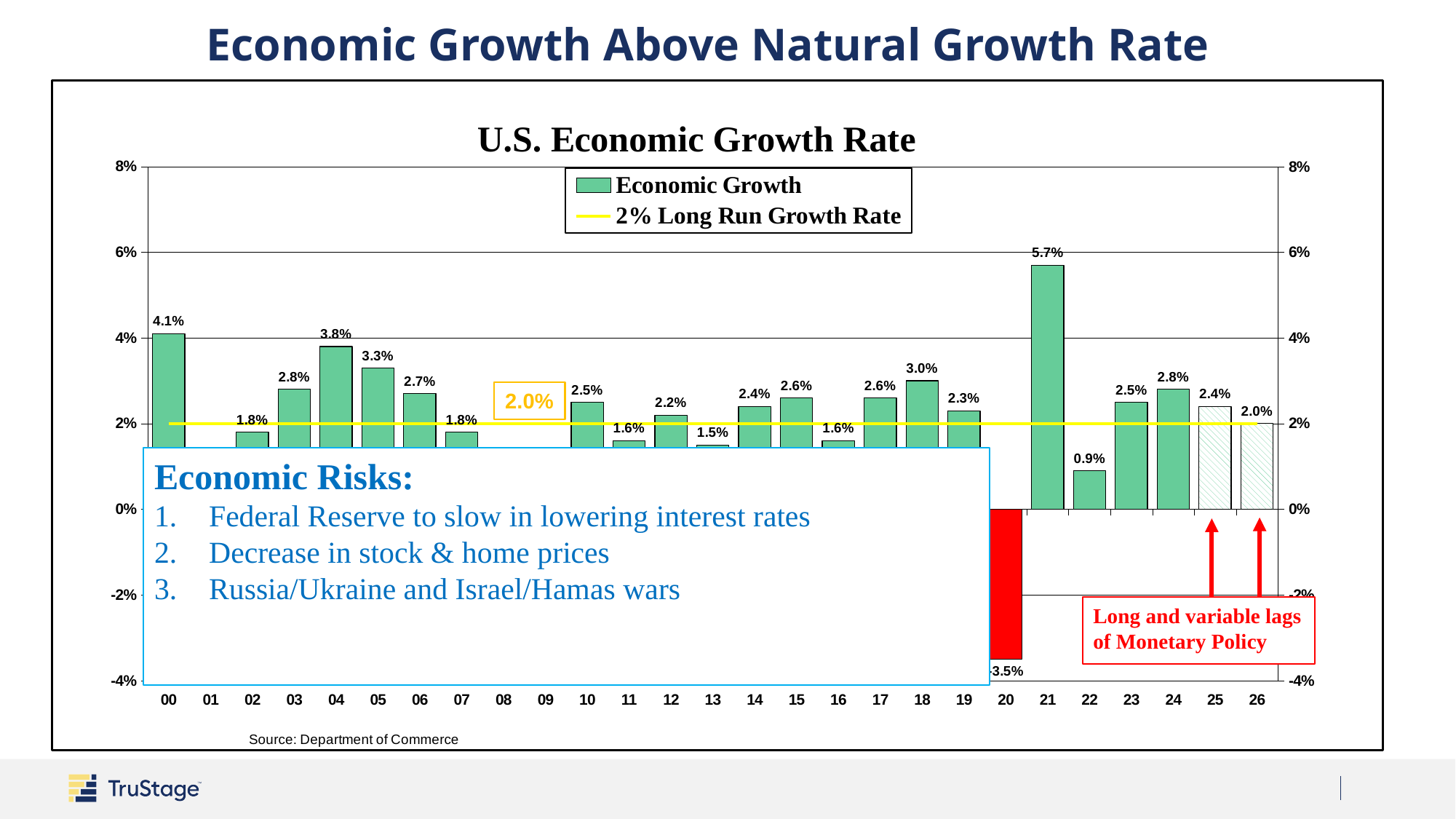
Which year has a higher economic growth rate, 2004 or 2005? 04 What is the economic growth rate shown for 2020 (labelled 20)? -3.5% How many series does the legend list? 2 What kind of chart is used to show the U.S. Economic Growth Rate? Combination bar and line chart Which year has the highest economic growth rate on the chart? 21 Is the economic growth rate for 2018 greater or less than 2%? greater What is the difference between the economic growth rate for 2021 (5.7%) and 2022 (0.9%)? 4.8% What is the economic growth rate shown for 2022 (labelled 22)? 0.9% Which year has the lowest economic growth rate on the chart? 20 What is the economic growth rate shown for 2000 (labelled 00)? 4.1% What is the economic growth rate shown for 2021 (labelled 21)? 5.7% What is the title of the chart? U.S. Economic Growth Rate